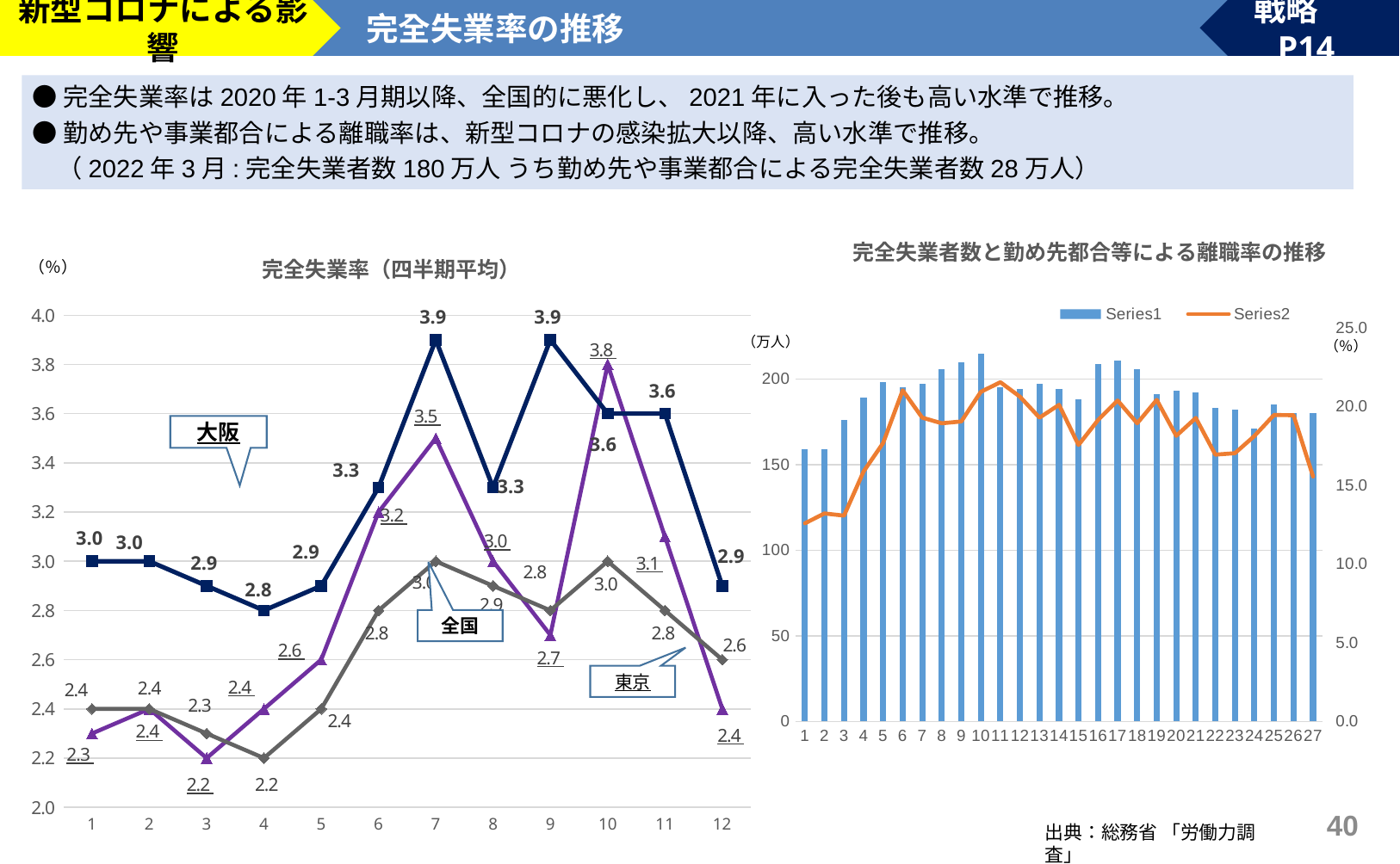
In the right chart 完全失業者数と勤め先都合等による離職率の推移, is the Series1 bar for category 1 greater or less than 200? less In the left chart 完全失業率（四半期平均）, which is larger at point 10, 大阪 or 東京? 東京 In the right chart 完全失業者数と勤め先都合等による離職率の推移, is the Series1 bar for category 10 greater or less than 200? greater How many categories are on the x axis of the right chart 完全失業者数と勤め先都合等による離職率の推移? 27 In the left chart 完全失業率（四半期平均）, what is the value for 全国 at point 12? 2.6 What kind of chart is the left chart titled 完全失業率（四半期平均）? line chart In the left chart 完全失業率（四半期平均）, what is the value for 大阪 at point 7? 3.9 In the left chart 完全失業率（四半期平均）, at which point is the value for 大阪 lowest? 4 In the left chart 完全失業率（四半期平均）, at which point is the value for 東京 highest? 10 How many points are plotted along the x axis of the left chart 完全失業率（四半期平均）? 12 How many series does the legend of the right chart 完全失業者数と勤め先都合等による離職率の推移 list? 2 In the left chart 完全失業率（四半期平均）, what is the difference between 大阪 and 東京 at point 1? 0.7